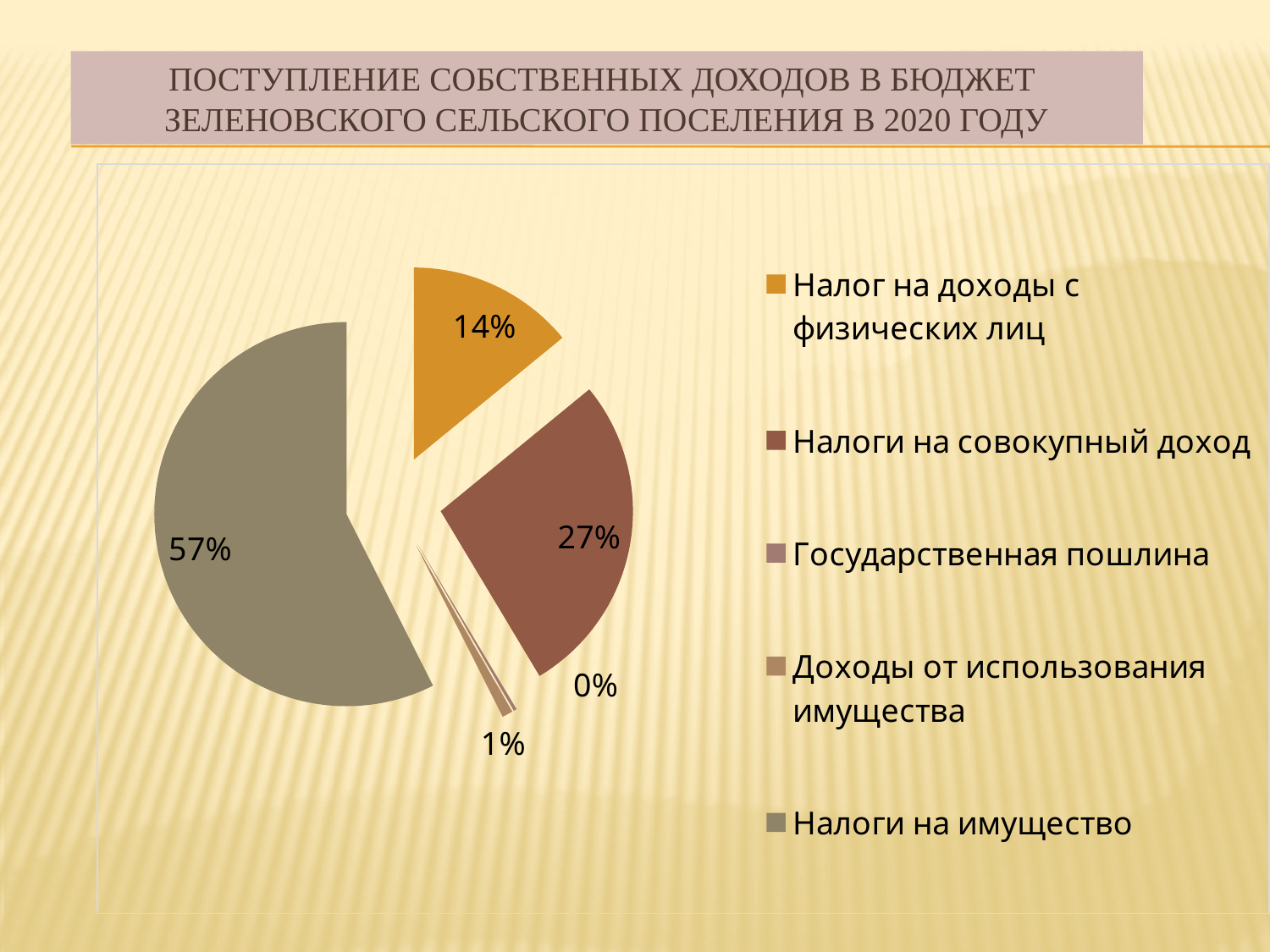
What share of the pie does "Государственная пошлина" have? 0% What share of the pie does "Налог на доходы с физических лиц" have? 14% What share of the pie does "Налоги на совокупный доход" have? 27% How many categories does the legend list? 5 Which category has the largest slice of the pie? Налоги на имущество What colour is the slice for "Налог на доходы с физических лиц"? orange Which category has the smallest slice of the pie? Государственная пошлина What is the difference between the shares of "Налоги на имущество" and "Налоги на совокупный доход"? 30% What type of chart is shown on the slide? pie chart Which is larger: the share of "Налоги на совокупный доход" or the share of "Налог на доходы с физических лиц"? Налоги на совокупный доход